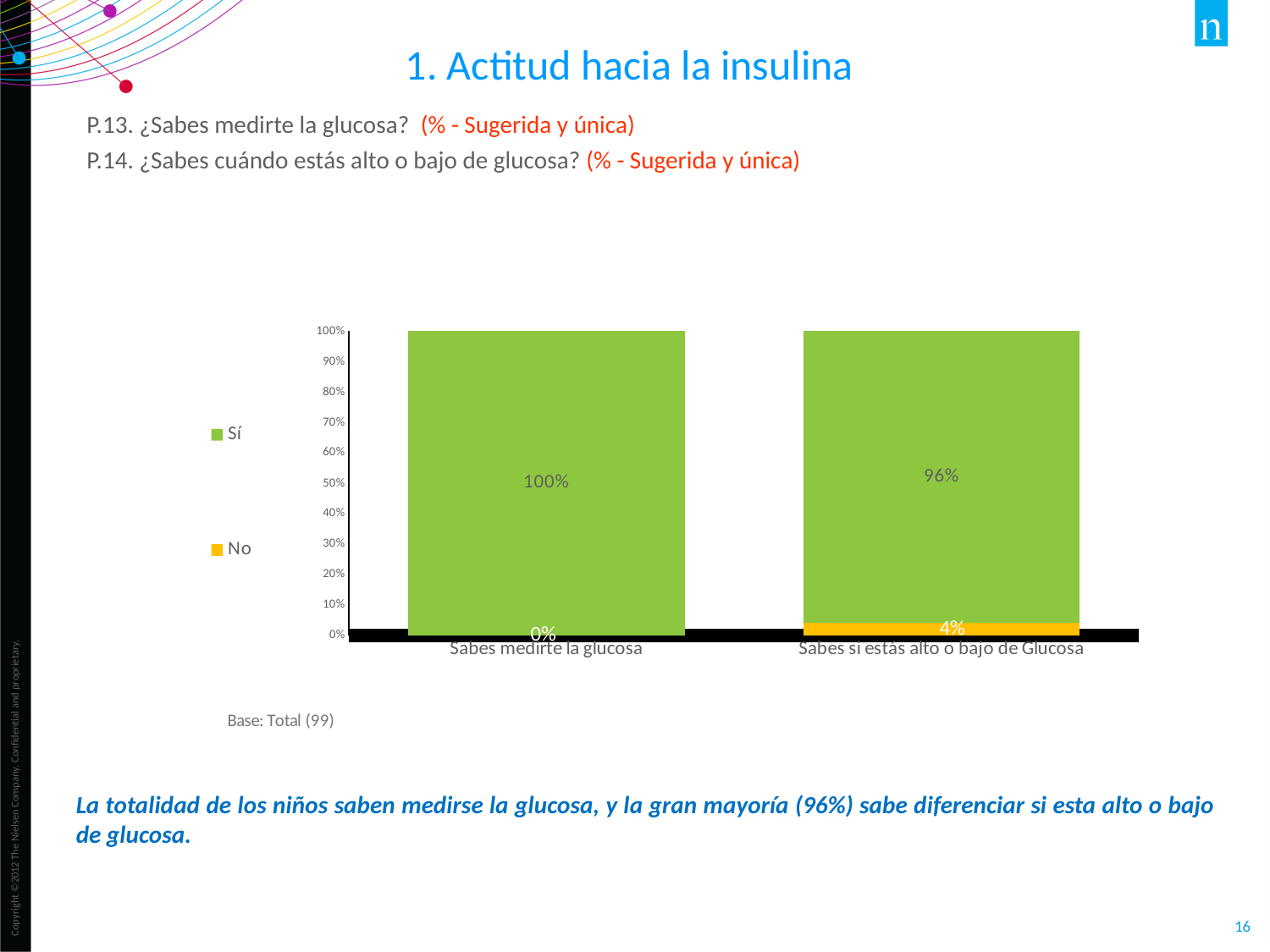
How many series does the chart legend list? 2 How many categories are shown on the x axis of the chart? 2 What is the difference between the "Sí" values for "Sabes medirte la glucosa" and "Sabes si estás alto o bajo de Glucosa"? 4% What is the "No" value for "Sabes medirte la glucosa"? 0% Is the "No" value larger for "Sabes medirte la glucosa" or for "Sabes si estás alto o bajo de Glucosa"? Sabes si estás alto o bajo de Glucosa What is the "No" value for "Sabes si estás alto o bajo de Glucosa"? 4% Which category has the lower "Sí" value? Sabes si estás alto o bajo de Glucosa What is the "Sí" value for "Sabes medirte la glucosa"? 100% What is the total of the stacked bar for "Sabes si estás alto o bajo de Glucosa"? 100% What kind of chart is shown on the slide? bar chart Which category has the higher "Sí" value? Sabes medirte la glucosa What is the "Sí" value for "Sabes si estás alto o bajo de Glucosa"? 96%